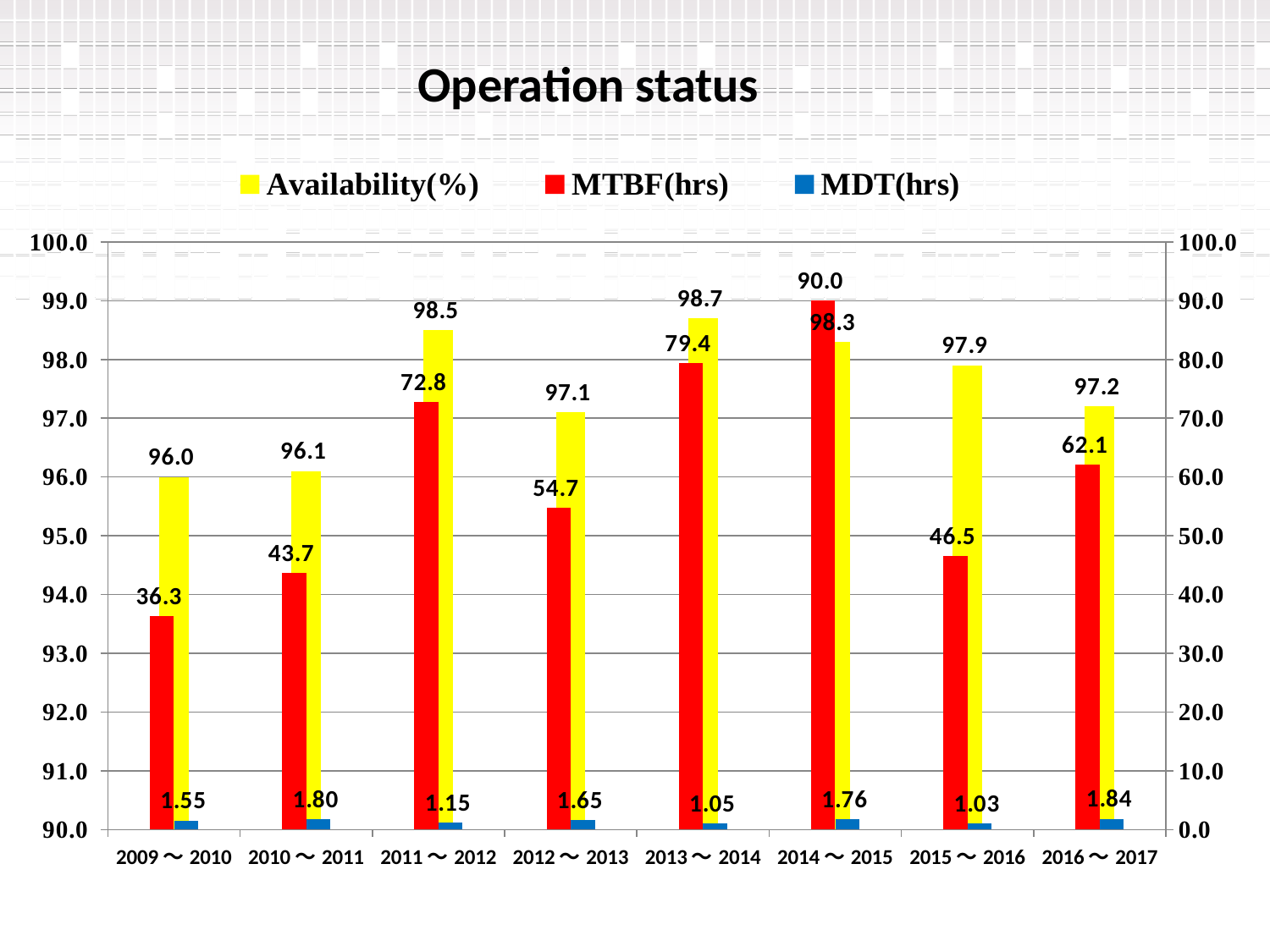
What is the Availability(%) value for 2011～2012? 98.5 How many periods are shown on the x axis? 8 What is the MDT(hrs) value for 2016～2017? 1.84 What kind of chart is shown on the slide? Bar chart What is the MTBF(hrs) value for 2014～2015? 90.0 What is the title of the chart? Operation status Which is larger, the MTBF(hrs) for 2011～2012 or for 2012～2013? 2011～2012 What is the difference in MTBF(hrs) between 2014～2015 and 2009～2010? 53.7 Which period has the lowest MDT(hrs)? 2015～2016 Which period has the highest Availability(%)? 2013～2014 Which period has the lowest MTBF(hrs)? 2009～2010 How many series does the legend list? 3